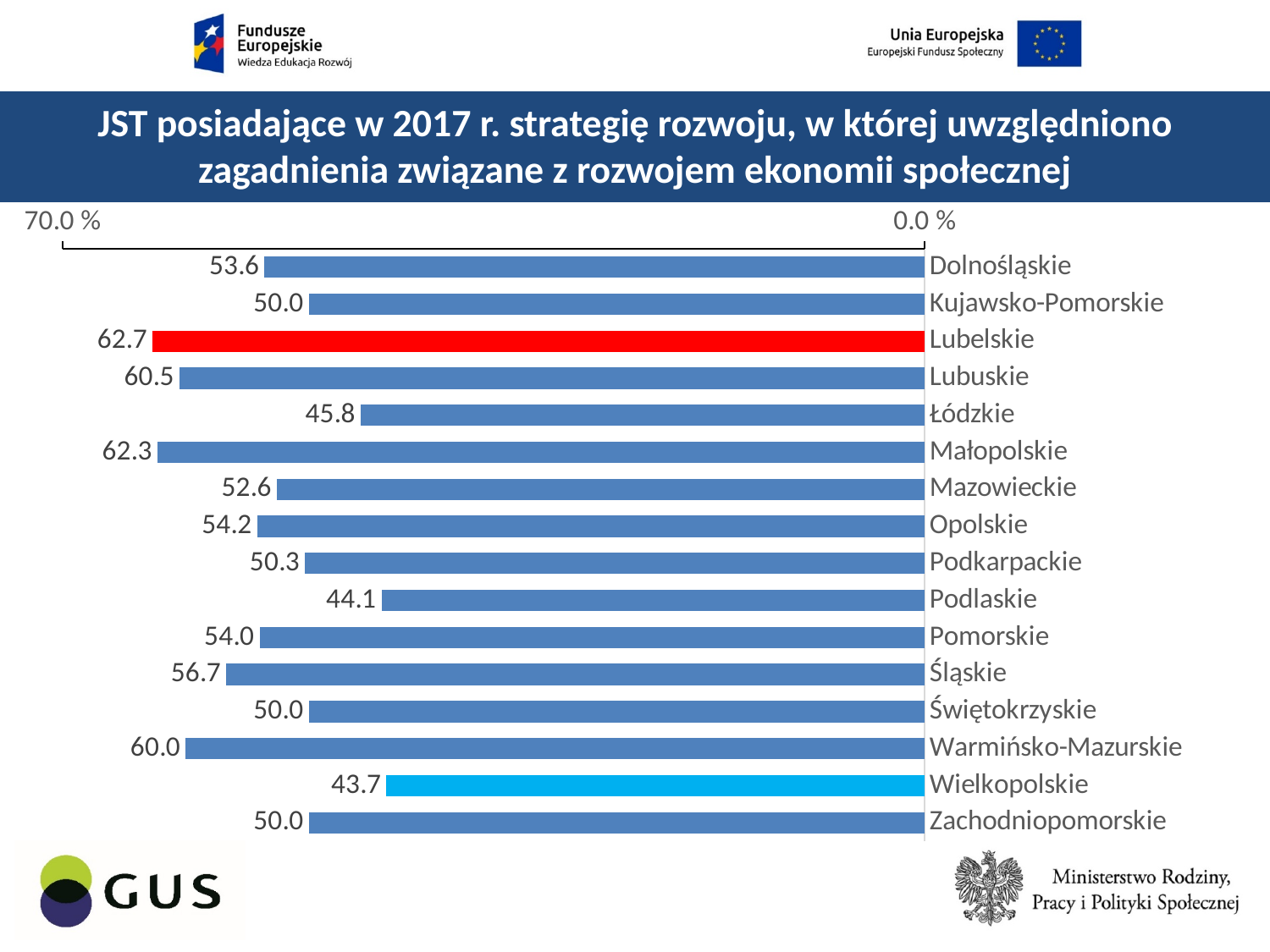
Which region has the highest value? Lubelskie Which is larger, the value for Opolskie or the value for Pomorskie? Opolskie What is the difference between the values for Lubelskie and Wielkopolskie? 19.0 What kind of chart is shown on the slide? Bar chart How many regions are shown in the chart? 16 What is the difference between the values for Śląskie and Łódzkie? 10.9 Which region's bar is coloured red? Lubelskie Which region has the lowest value? Wielkopolskie What is the value for Dolnośląskie? 53.6 What is the value for Podlaskie? 44.1 Which is larger, the value for Mazowieckie or the value for Podkarpackie? Mazowieckie What is the value for Warmińsko-Mazurskie? 60.0